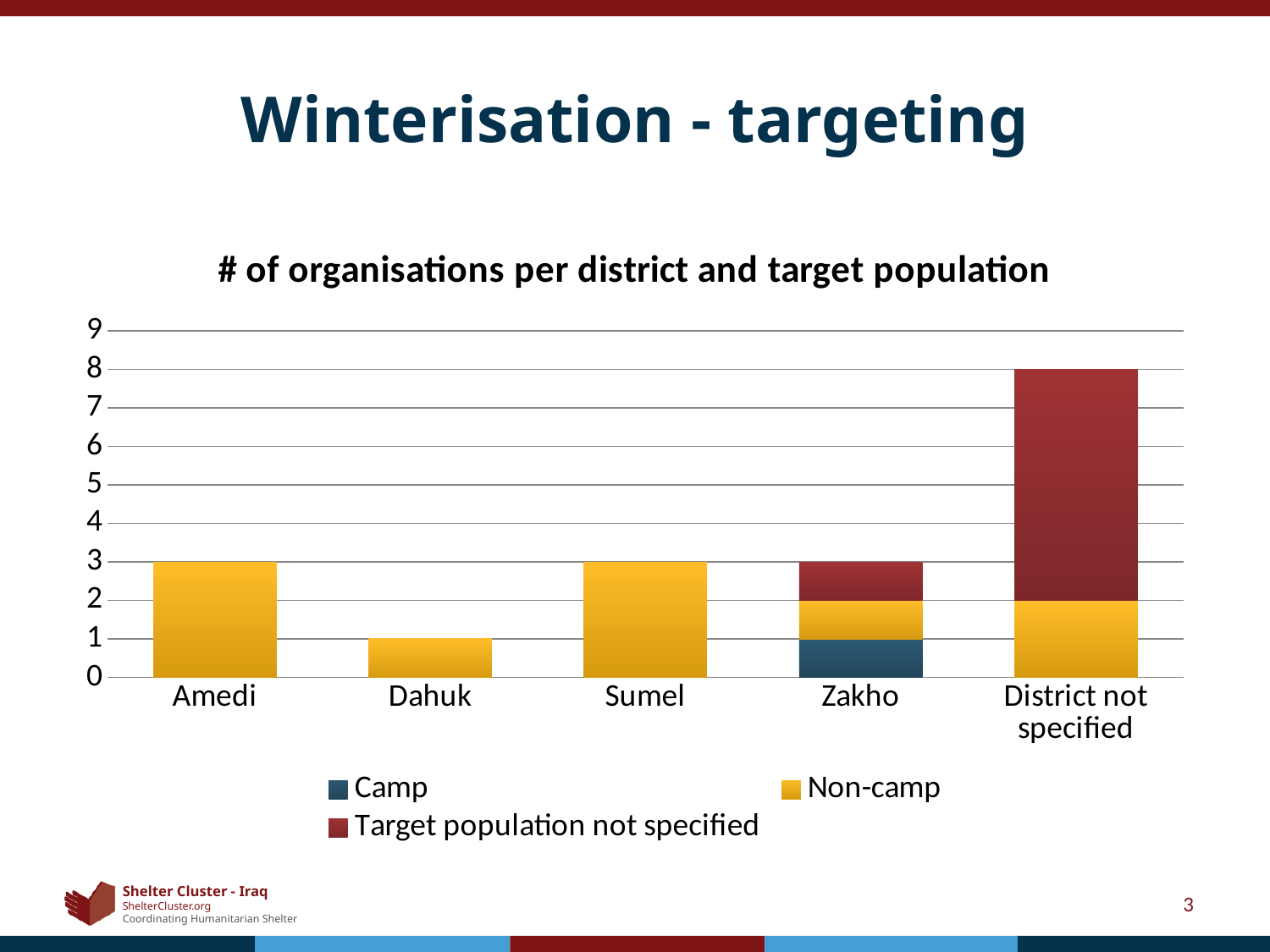
What is the total number of organisations for Zakho? 3 What kind of chart is shown on the slide? Stacked bar chart How many districts (categories) are shown on the x axis? 5 What is the number of Non-camp organisations for Amedi? 3 Which district is the only one with a Camp segment in its bar? Zakho What is the difference between the total for 'District not specified' and the total for Sumel? 5 How many series does the legend list? 3 Which is larger, the total for Amedi or the total for Dahuk? Amedi What is the total number of organisations for 'District not specified'? 8 Which district has the lowest total number of organisations? Dahuk Which district has the highest total number of organisations? District not specified What is the number of organisations for Dahuk? 1